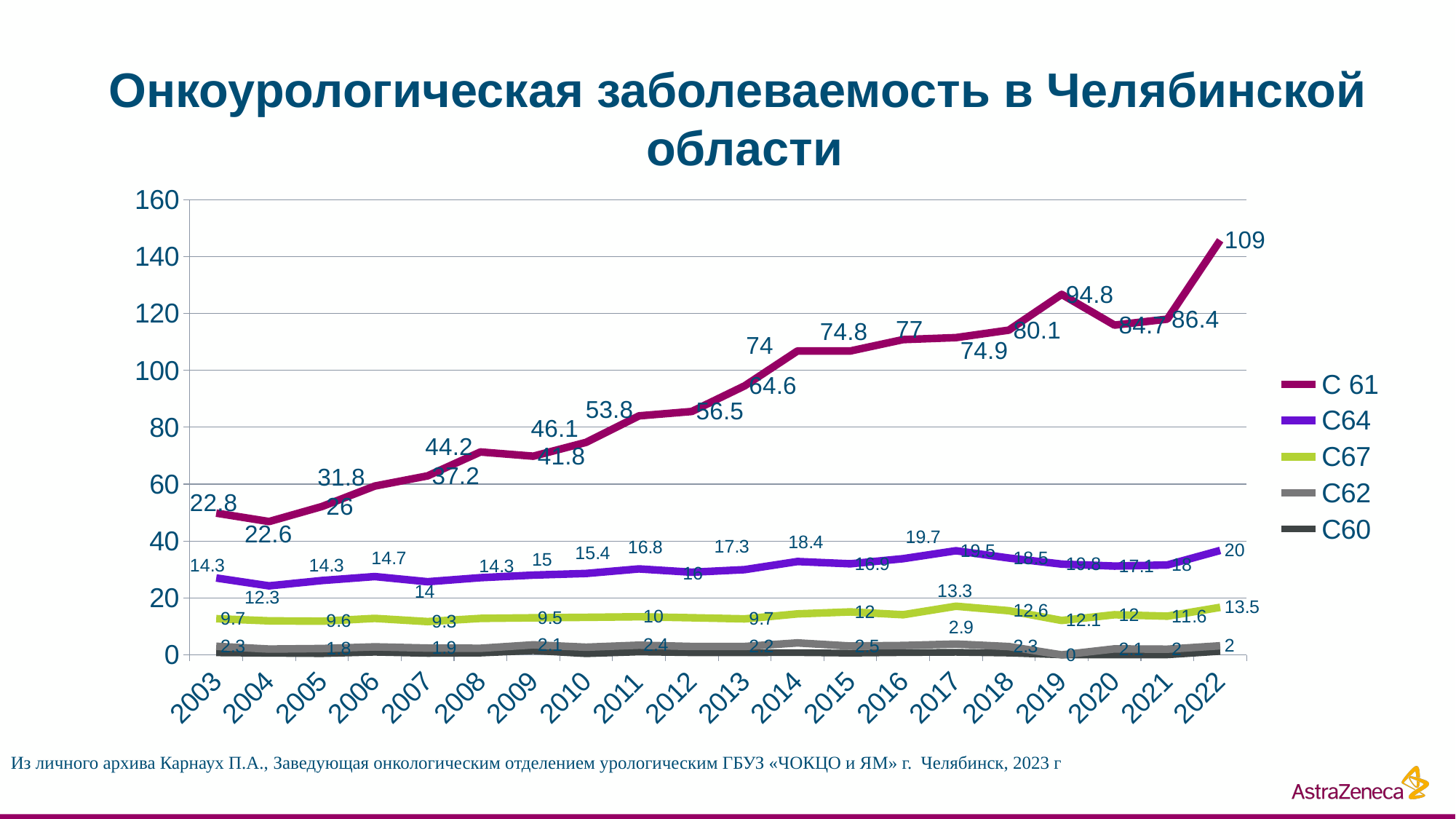
What is the title of the chart? Онкоурологическая заболеваемость в Челябинской области Does the C 61 series generally rise or fall from 2003 to 2022? rise Which year has the larger C 61 value, 2019 or 2020? 2019 What is the value for C64 in 2022? 20 In which year does the C 61 series reach its highest value? 2022 What is the value for C 61 in 2003? 22.8 How many series does the legend list? 5 What is the value for C 61 in 2022? 109 What is the value for C67 in 2017? 13.3 What kind of chart is shown on the slide? line chart What is the difference between the C 61 values for 2022 and 2003? 86.2 How many years are shown along the x axis? 20